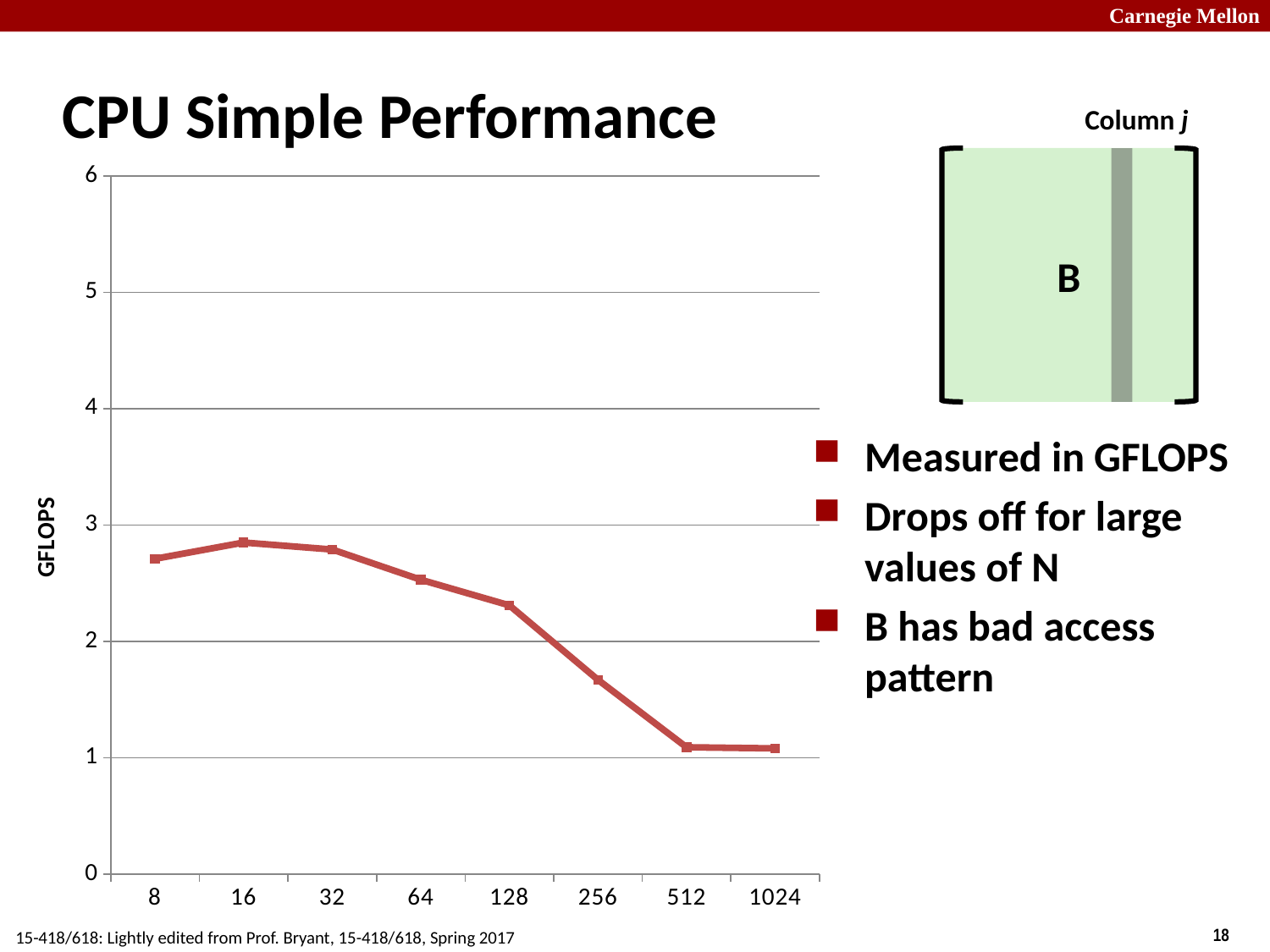
How many data points are plotted on the line? 8 What is the label on the vertical axis of the chart? GFLOPS Which has the higher GFLOPS value, 128 or 512? 128 What is the title of the chart? CPU Simple Performance Is the value for 64 greater or less than 3? less What kind of chart is shown on the slide? line chart Is the value for 512 greater or less than 1? greater Is the value for 8 greater or less than 2? greater Do the GFLOPS values generally rise or fall as N increases from 32 to 512? fall Which has the higher GFLOPS value, 8 or 256? 8